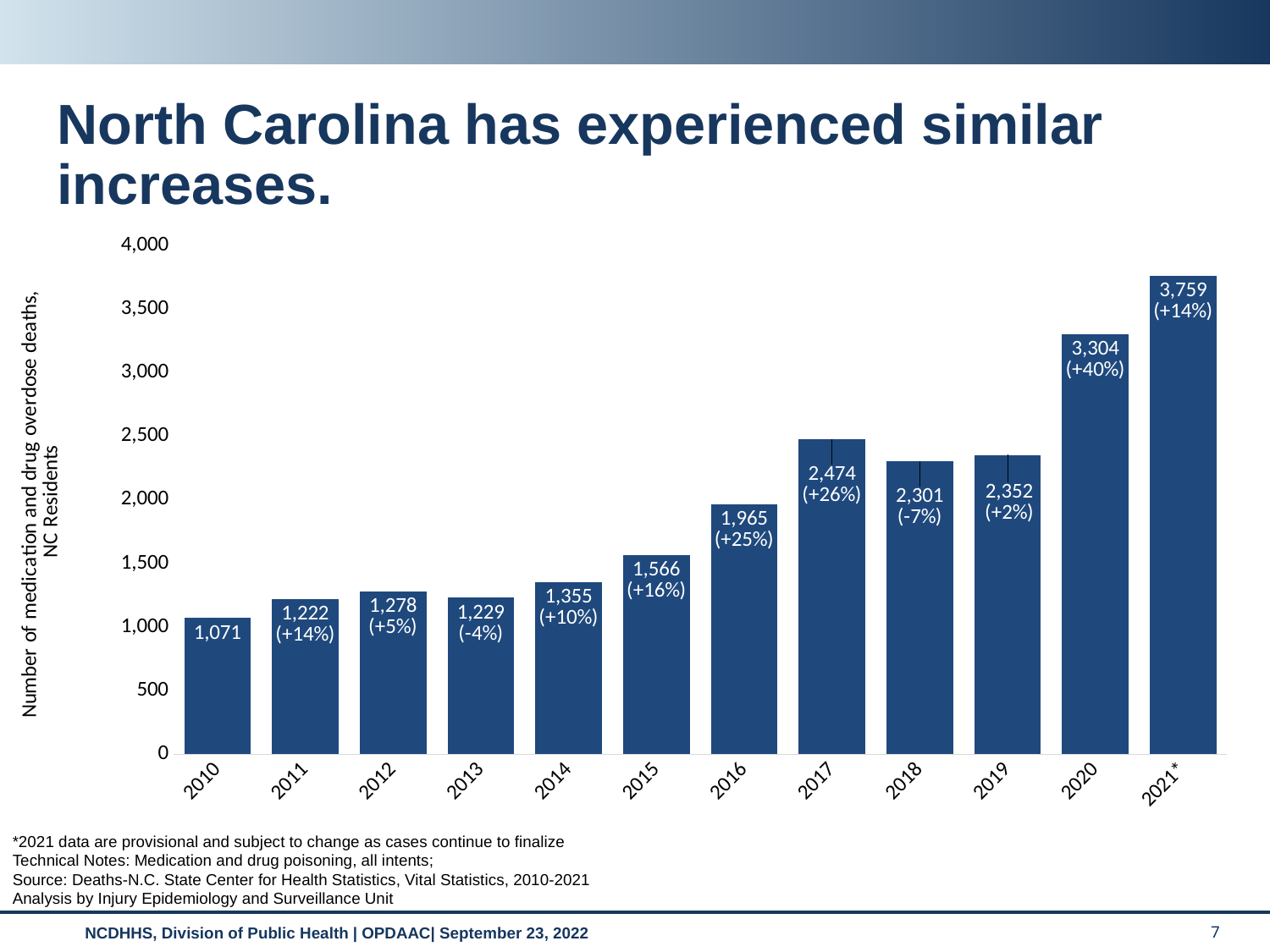
What is the number of medication and drug overdose deaths for 2017? 2,474 Is the value for 2016 greater or less than 2,000? less Which year has the highest number of medication and drug overdose deaths? 2021* What is the number of medication and drug overdose deaths for 2010? 1,071 What percentage change is shown for 2020? +40% Which year had more deaths, 2012 or 2013? 2012 What is the difference in deaths between 2017 and 2018? 173 What is the difference in deaths between 2021* and 2020? 455 Which year has the lowest number of medication and drug overdose deaths? 2010 How many years are shown on the x axis? 12 What is the number of medication and drug overdose deaths for 2020? 3,304 What kind of chart is shown on the slide? bar chart